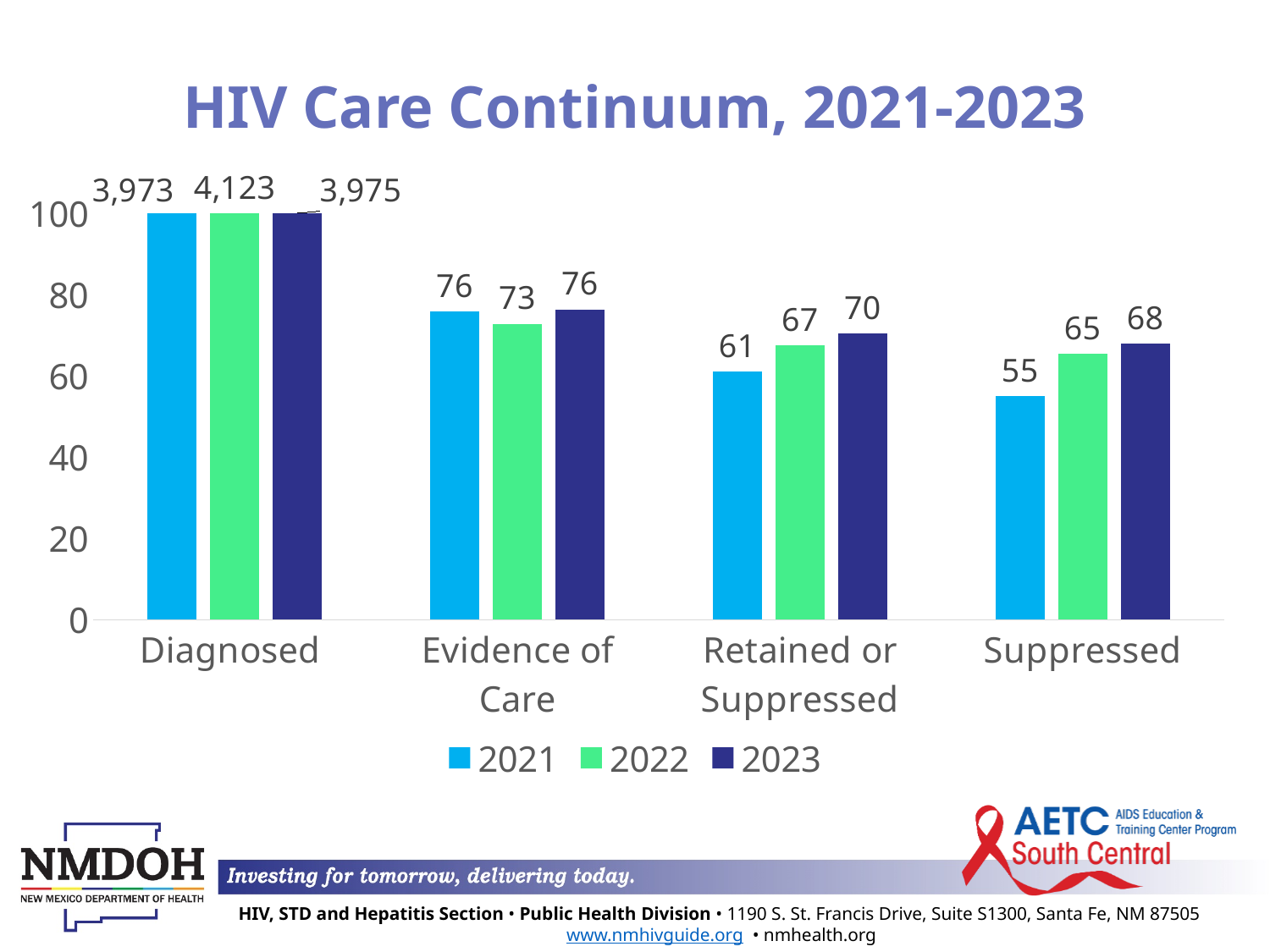
What is the value for 2023 in the Retained or Suppressed category? 70 Which is larger: the 2022 value for Retained or Suppressed or the 2022 value for Suppressed? Retained or Suppressed What is the value for 2021 in the Suppressed category? 55 Which year has the highest value in the Retained or Suppressed category? 2023 What kind of chart is shown on the slide? Bar chart What is the difference between the 2023 and 2021 values in the Suppressed category? 13 What is the value for 2022 in the Evidence of Care category? 73 How many series does the legend list? 3 What is the data label shown for the 2022 bar in the Diagnosed category? 4,123 Do the values for 2021 rise or fall from Evidence of Care to Suppressed? Fall How many categories are shown on the x axis? 4 Which year has the lowest value in the Suppressed category? 2021